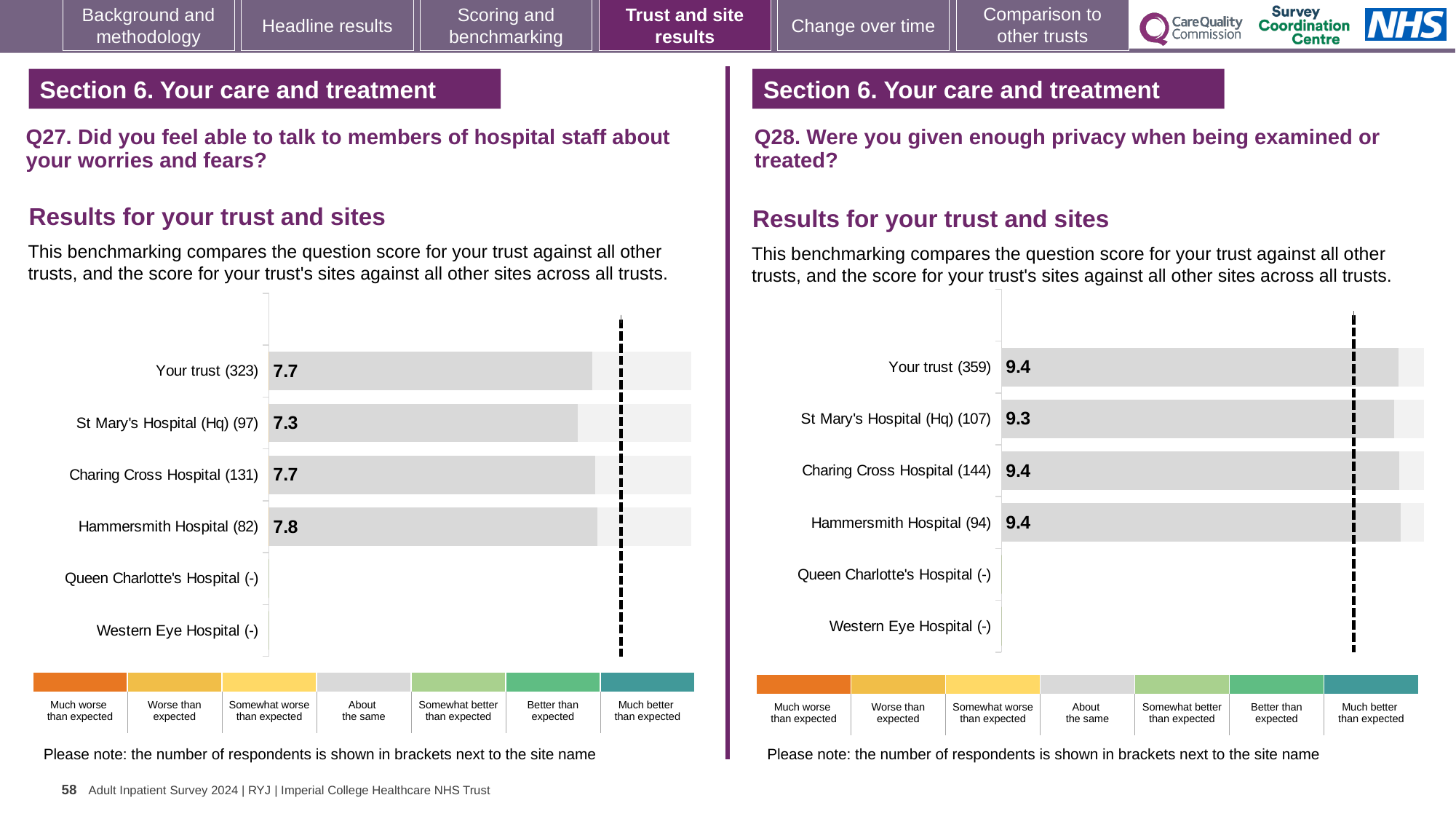
On the Q27 chart (left), what is the difference between the scores for Hammersmith Hospital and St Mary's Hospital (Hq)? 0.5 On the Q27 chart (left), what is the score for St Mary's Hospital (Hq)? 7.3 What type of chart is used on the Q27 chart (left)? Bar chart On the Q28 chart (right), what is the score for St Mary's Hospital (Hq)? 9.3 On the Q27 chart (left), what is the score for Your trust? 7.7 On the Q28 chart (right), what is the score for Your trust? 9.4 On the Q28 chart (right), which site has the lowest score? St Mary's Hospital (Hq) On the Q28 chart (right), how many rows (sites including Your trust) are listed on the vertical axis? 6 On the Q27 chart (left), how many respondents are shown in brackets for Charing Cross Hospital? 131 On the Q28 chart (right), which is larger: the score for Charing Cross Hospital or St Mary's Hospital (Hq)? Charing Cross Hospital On the Q27 chart (left), which site has the lowest score? St Mary's Hospital (Hq) On the Q27 chart (left), which site has the highest score? Hammersmith Hospital